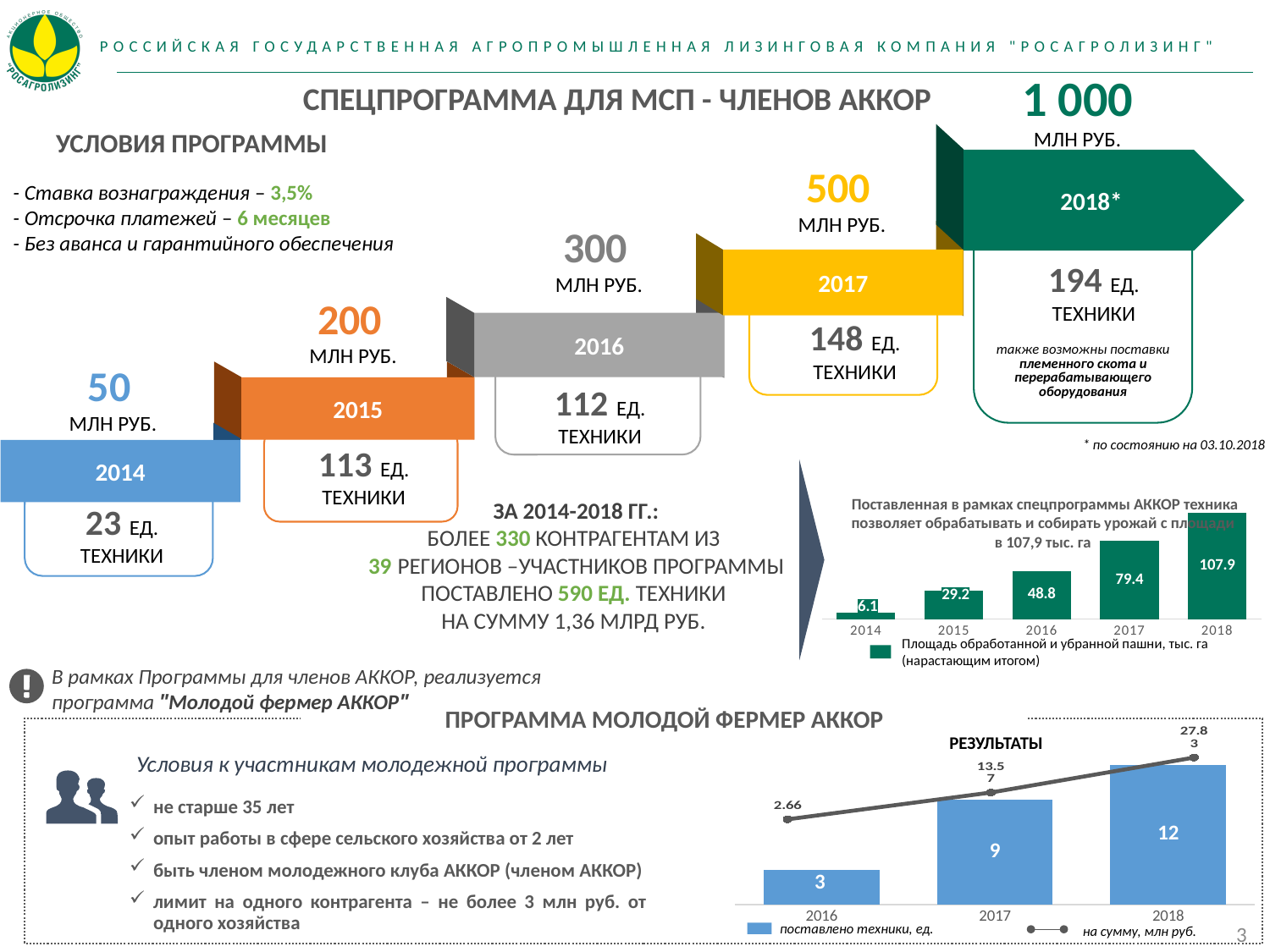
In the 'РЕЗУЛЬТАТЫ' chart at the bottom right, which year has the lowest number of delivered equipment units? 2016 How many series does the legend of the 'РЕЗУЛЬТАТЫ' chart at the bottom right list? 2 In the 'РЕЗУЛЬТАТЫ' chart at the bottom right, what is the difference in delivered equipment units between 2018 and 2017? 3 In the chart on the right middle of the slide (area of cultivated and harvested arable land), what is the value for 2016? 48.8 In the 'РЕЗУЛЬТАТЫ' chart at the bottom right, what is the value of the line series (на сумму, млн руб.) for 2016? 2.66 In the chart on the right middle of the slide (area of cultivated and harvested arable land), do the values rise or fall from 2014 to 2018? rise In the 'РЕЗУЛЬТАТЫ' chart at the bottom right, how many units of equipment were delivered in 2017? 9 In the chart on the right middle of the slide (area of cultivated and harvested arable land), what is the value for 2014? 6.1 In the chart on the right middle of the slide (area of cultivated and harvested arable land), what is the difference between the 2018 and 2017 values? 28.5 In the chart on the right middle of the slide (area of cultivated and harvested arable land), which year has the highest value? 2018 What type of chart is the chart on the right middle of the slide showing the area of cultivated and harvested arable land? bar chart How many years are shown on the x axis of the chart on the right middle of the slide (area of cultivated and harvested arable land)? 5